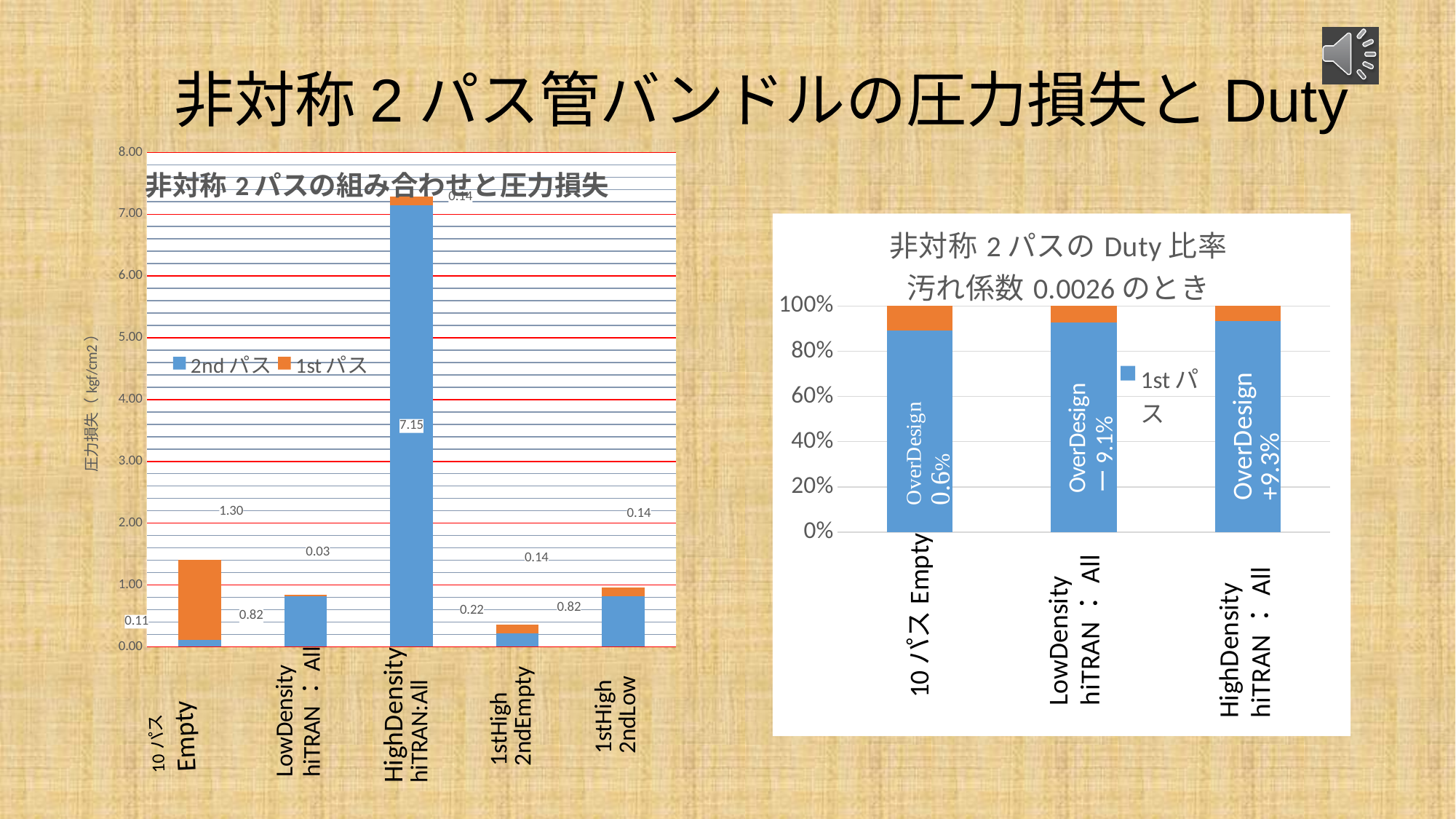
In the right chart (非対称 2 パスの Duty 比率), how many categories are shown? 3 What kind of chart is the left chart titled 非対称 2 パスの組み合わせと圧力損失? Stacked bar chart In the left chart (非対称 2 パスの組み合わせと圧力損失), what is the 1st パス value for 10 パス Empty? 1.30 In the left chart (非対称 2 パスの組み合わせと圧力損失), which category has the highest total pressure loss? HighDensity hiTRAN:All In the left chart (非対称 2 パスの組み合わせと圧力損失), is the total for HighDensity hiTRAN:All greater or less than 7.00? greater In the left chart (非対称 2 パスの組み合わせと圧力損失), what is the 2nd パス value for HighDensity hiTRAN:All? 7.15 In the left chart (非対称 2 パスの組み合わせと圧力損失), how many categories are shown on the x axis? 5 In the right chart (非対称 2 パスの Duty 比率), what OverDesign value is printed on the bar for HighDensity hiTRAN：All? +9.3% In the left chart (非対称 2 パスの組み合わせと圧力損失), what is the total of the stacked bar for HighDensity hiTRAN:All? 7.29 In the left chart (非対称 2 パスの組み合わせと圧力損失), how many series does the legend list? 2 In the left chart (非対称 2 パスの組み合わせと圧力損失), which has the larger total bar: 10 パス Empty or LowDensity hiTRAN：All? 10 パス Empty What is the y-axis label of the left chart (非対称 2 パスの組み合わせと圧力損失)? 圧力損失（kgf/cm2）